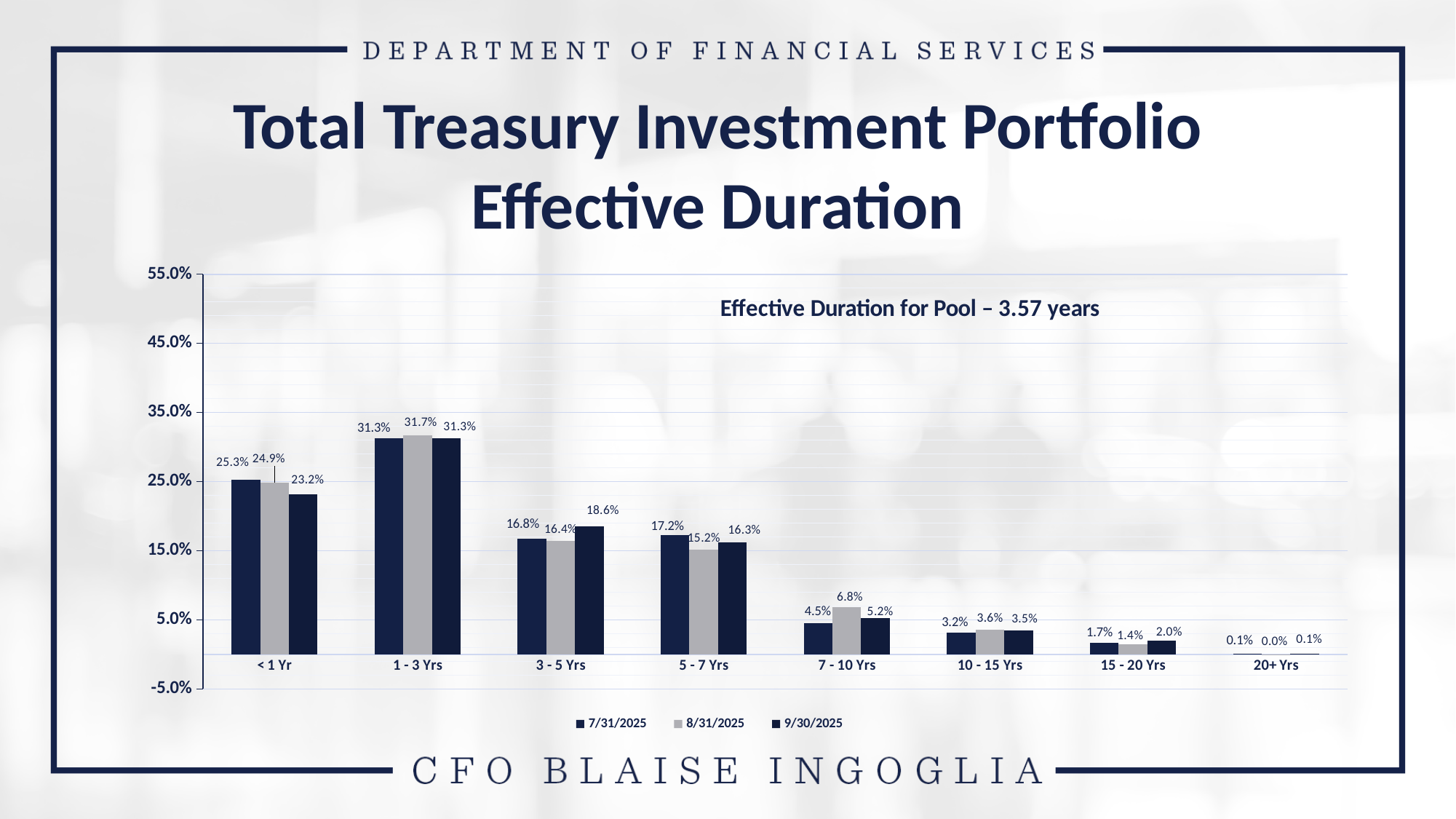
What is the value for the 7 - 10 Yrs category in the 9/30/2025 series? 5.2% What is the value for the 1 - 3 Yrs category in the 8/31/2025 series? 31.7% Is the 8/31/2025 value for the 5 - 7 Yrs category greater or less than 25.0%? less What kind of chart is shown on the slide? Bar chart What is the difference between the 7/31/2025 and 9/30/2025 values for the < 1 Yr category? 2.1% Which category has the highest value in the 9/30/2025 series? 1 - 3 Yrs For the 3 - 5 Yrs category, which series has the larger value: 7/31/2025 or 9/30/2025? 9/30/2025 What is the effective duration for the pool stated on the chart? 3.57 years What is the value for the < 1 Yr category in the 7/31/2025 series? 25.3% How many series does the legend list? 3 How many maturity categories are shown on the x axis? 8 Which category has the lowest value in the 8/31/2025 series? 20+ Yrs